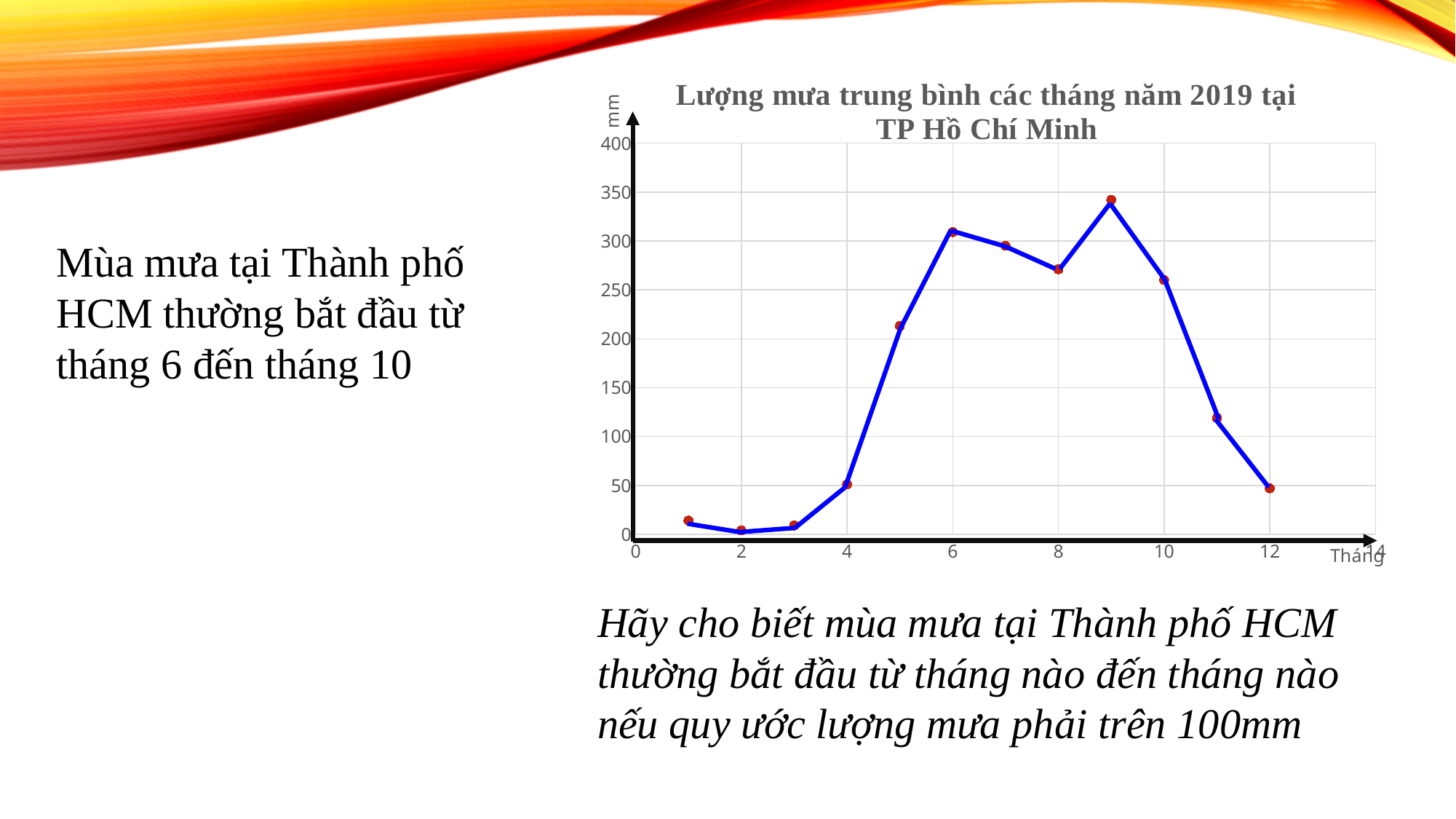
Is the value for month 4 greater or less than 100? less Which month has the highest rainfall value on the chart? 9 How many data points are plotted on the line? 12 What is the title of the chart? Lượng mưa trung bình các tháng năm 2019 tại TP Hồ Chí Minh Which is larger, the value for month 5 or the value for month 10? month 10 What kind of chart is shown on the slide? line chart Do the values rise or fall from month 9 to month 12? fall Which is larger, the value for month 9 or the value for month 6? month 9 Is the value for month 9 greater or less than 300? greater What unit is shown on the vertical axis of the chart? mm Is the value for month 11 greater or less than 100? greater